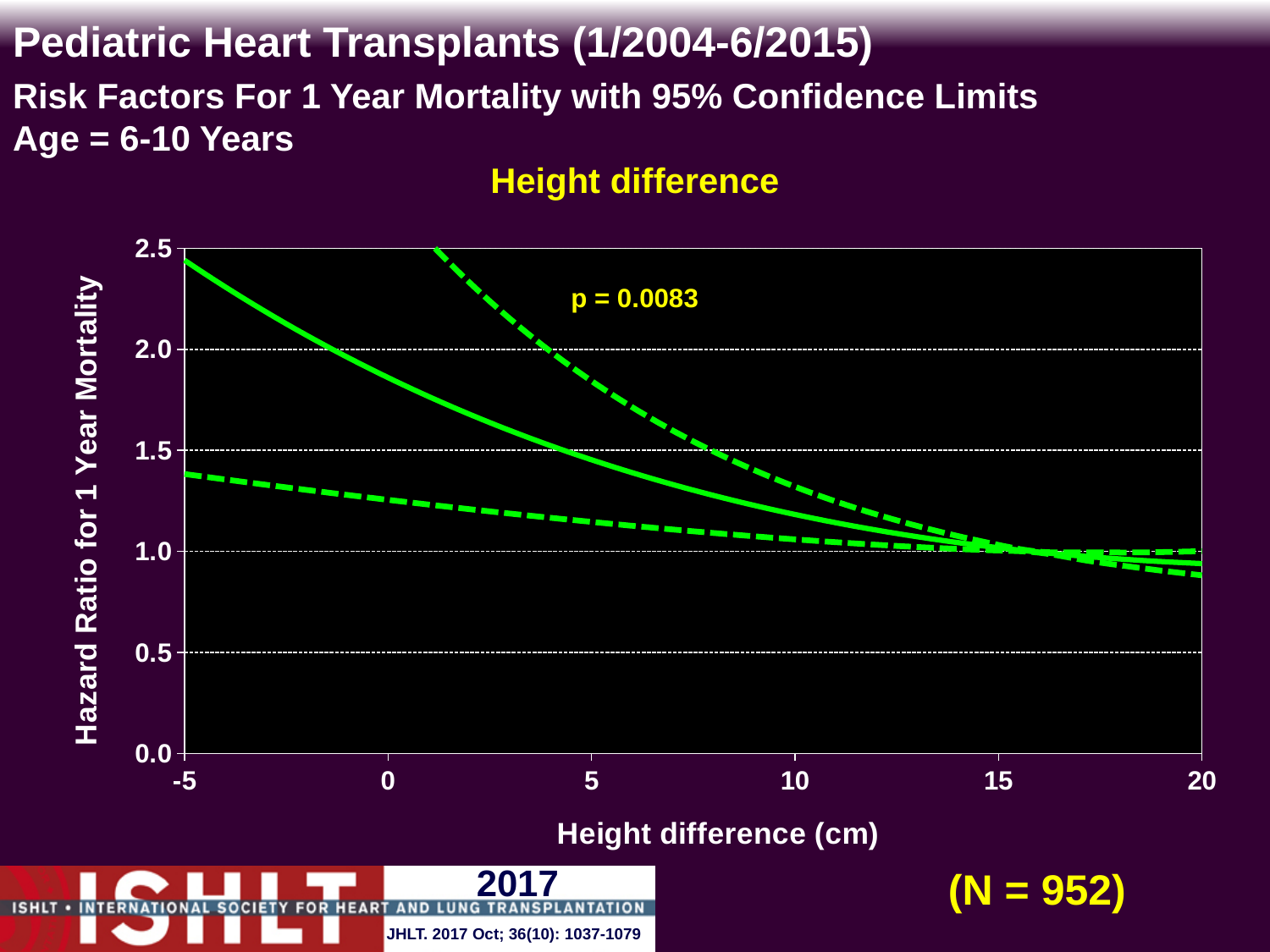
Is the solid-line hazard ratio at a height difference of 20 cm greater or less than 1.0? less Is the solid-line hazard ratio at a height difference of 10 cm greater or less than 1.5? less Is the solid-line hazard ratio at a height difference of 0 cm greater or less than 1.5? greater How many lines are plotted on the chart? 3 What is the label of the y axis? Hazard Ratio for 1 Year Mortality Does the solid hazard ratio line rise or fall as height difference increases from -5 to 20 cm? fall Is the solid-line hazard ratio higher at a height difference of -5 cm or at 15 cm? -5 cm What kind of chart is shown on the slide? line chart What p-value is printed on the chart? p = 0.0083